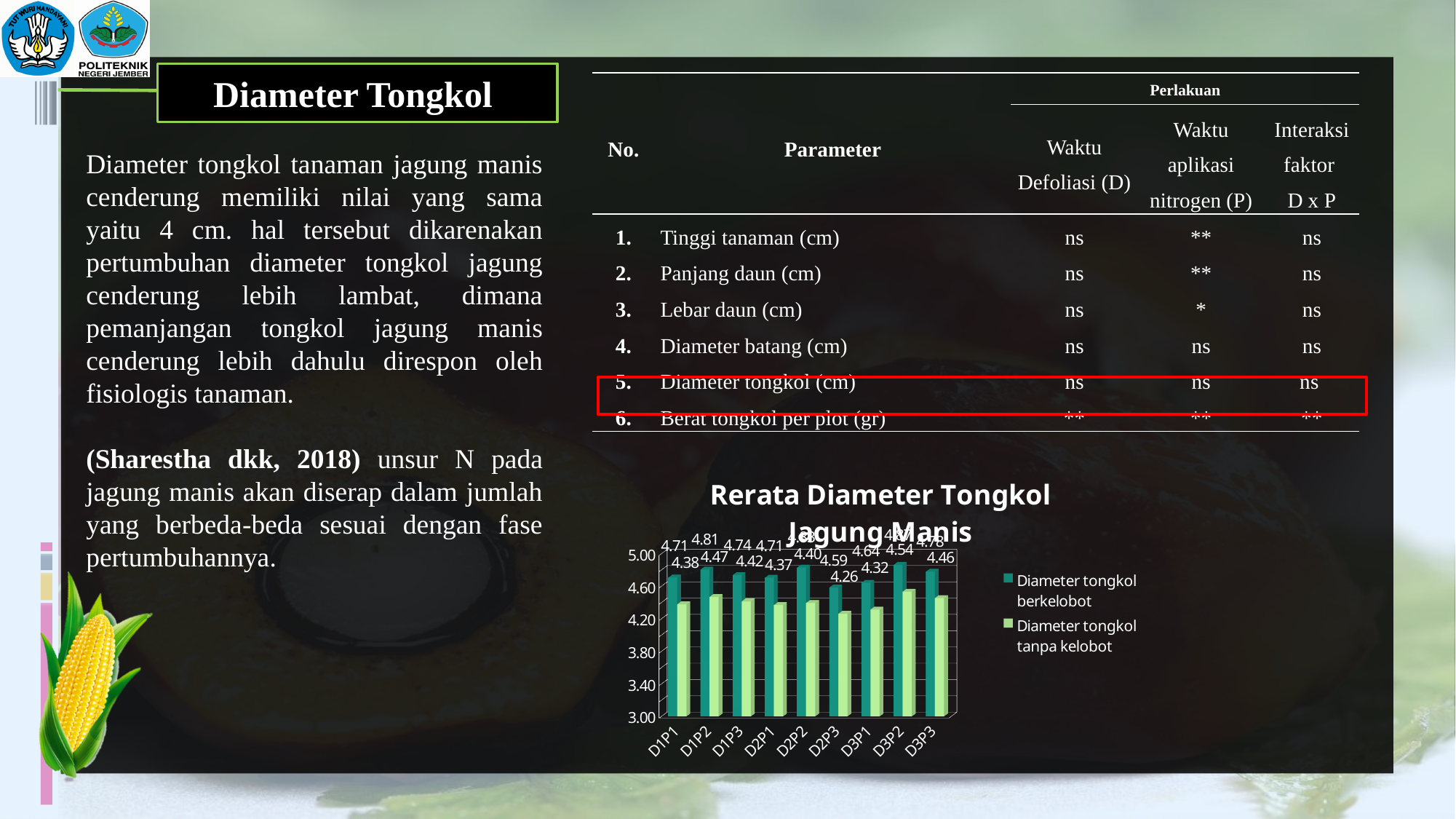
In the 'Rerata Diameter Tongkol Jagung Manis' chart, what is the value of 'Diameter tongkol berkelobot' for D1P1? 4.71 In the 'Rerata Diameter Tongkol Jagung Manis' chart, what is the value of 'Diameter tongkol tanpa kelobot' for D3P2? 4.54 In the 'Rerata Diameter Tongkol Jagung Manis' chart, which is larger: 'Diameter tongkol berkelobot' for D1P2 or for D1P1? D1P2 In the 'Rerata Diameter Tongkol Jagung Manis' chart, what is the value of 'Diameter tongkol tanpa kelobot' for D2P3? 4.26 How many series does the legend of the 'Rerata Diameter Tongkol Jagung Manis' chart list? 2 In the 'Rerata Diameter Tongkol Jagung Manis' chart, which category has the highest 'Diameter tongkol tanpa kelobot' value? D3P2 In the 'Rerata Diameter Tongkol Jagung Manis' chart, what is the value of 'Diameter tongkol berkelobot' for D3P3? 4.78 How many treatment categories are shown on the x axis of the 'Rerata Diameter Tongkol Jagung Manis' chart? 9 What type of chart is shown under the title 'Rerata Diameter Tongkol Jagung Manis'? bar chart In the 'Rerata Diameter Tongkol Jagung Manis' chart, which category has the lowest 'Diameter tongkol tanpa kelobot' value? D2P3 In the 'Rerata Diameter Tongkol Jagung Manis' chart, what is the difference between 'Diameter tongkol berkelobot' and 'Diameter tongkol tanpa kelobot' for D1P1? 0.33 In the 'Rerata Diameter Tongkol Jagung Manis' chart, is the 'Diameter tongkol berkelobot' value for D3P2 greater or less than 4.60? greater